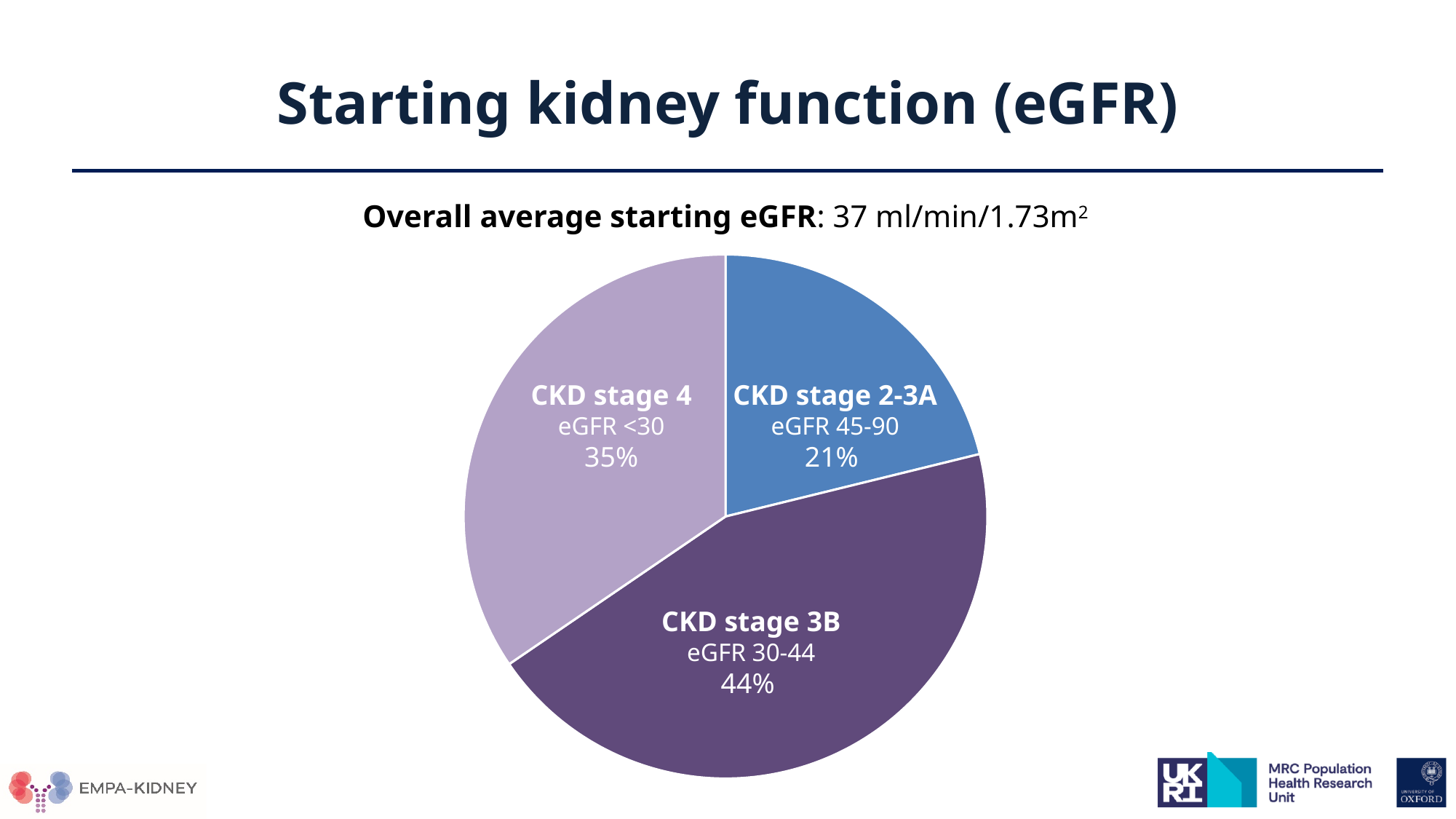
How many slices does the pie chart have? 3 What percentage of the pie is CKD stage 3B? 44% Which slice is larger, CKD stage 4 or CKD stage 2-3A? CKD stage 4 What is the difference in percentage points between CKD stage 4 and CKD stage 2-3A? 14 What kind of chart is shown on the slide? Pie chart What is the difference in percentage points between CKD stage 3B and CKD stage 4? 9 What percentage of the pie is CKD stage 4? 35% What is the overall average starting eGFR stated above the chart? 37 ml/min/1.73m² Which CKD stage has the largest slice of the pie? CKD stage 3B Which CKD stage has the smallest slice of the pie? CKD stage 2-3A What eGFR range is given for the CKD stage 3B slice? eGFR 30-44 What percentage of the pie is CKD stage 2-3A? 21%